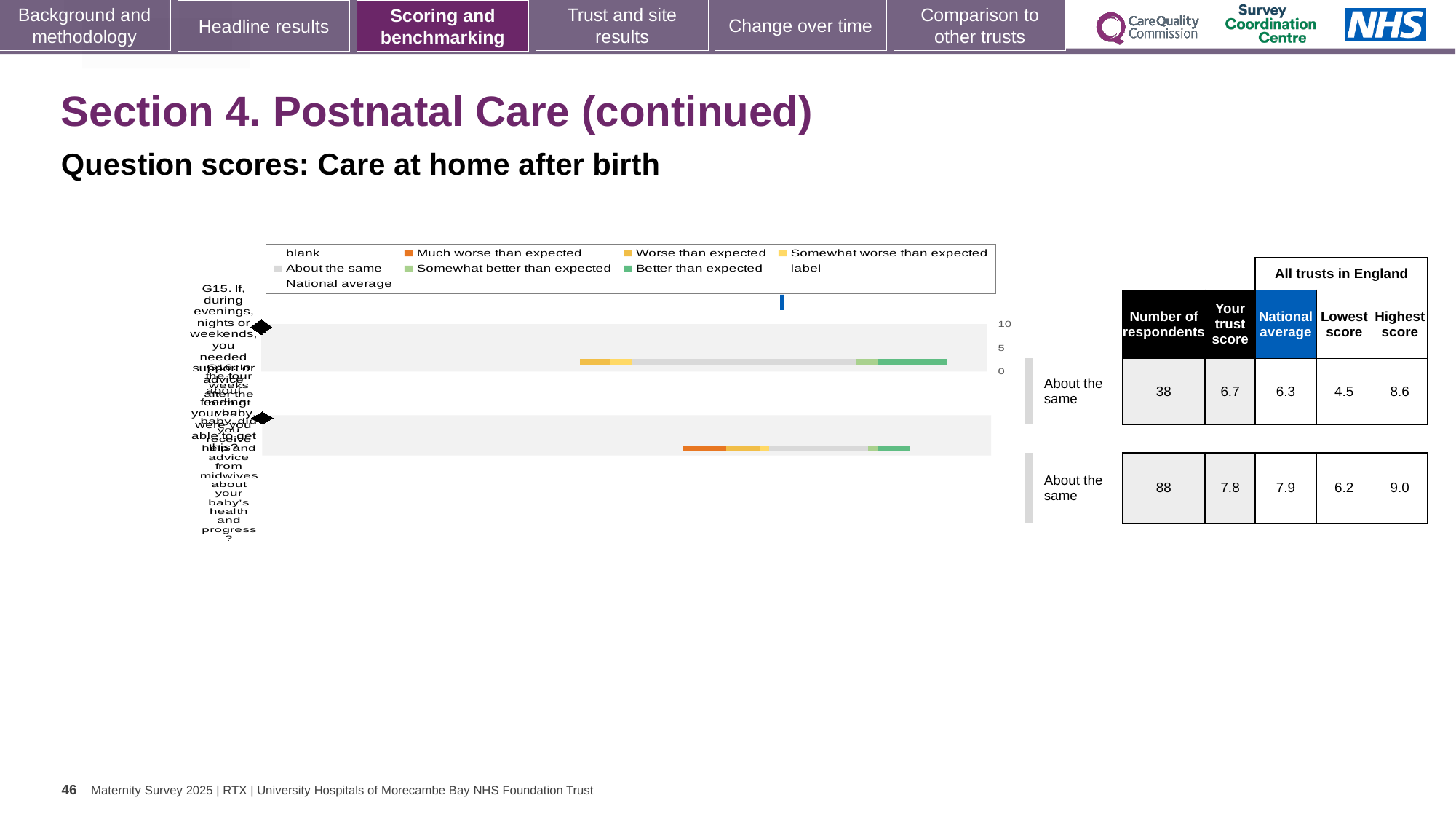
For the bottom question row, which is larger: the trust score or the national average? National average How many respondents are listed for the bottom question row? 88 How many question rows are plotted in the chart? 2 What is the national average for the bottom question row? 7.9 What is the difference between the highest score and the lowest score for the top question row? 4.1 What is the difference between the highest score and the lowest score for the bottom question row? 2.8 What colour is the 'Much worse than expected' legend entry? Orange What is the highest value shown on the chart's score axis? 10 What benchmark category is shown for the top question row? About the same What is the trust score for the top question row? 6.7 What kind of chart is shown on the slide? Bar chart For the top question row, which is larger: the trust score or the national average? Trust score